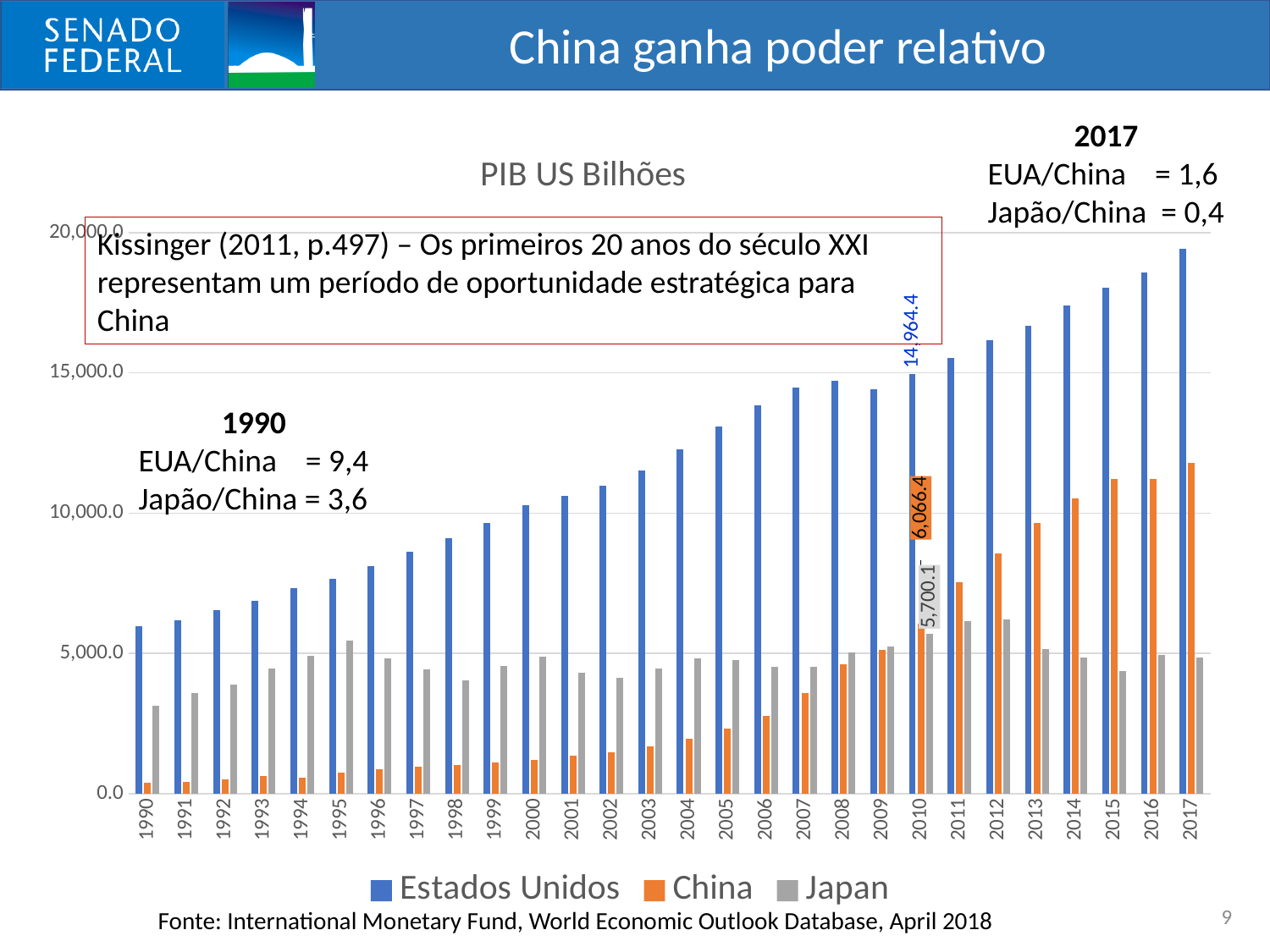
How many years are shown along the x axis of the chart? 28 Is the value for Estados Unidos in 2017 greater or less than 15,000.0? greater What is the value for Estados Unidos in 2010? 14,964.4 What is the value for Japan in 2010? 5,700.1 What is the title of the chart? PIB US Bilhões What is the value for China in 2010? 6,066.4 In 2010, which is larger, the value for China or the value for Japan? China Is the value for China in 1990 greater or less than 5,000.0? less Do the values for China rise or fall from 1990 to 2017? rise What kind of chart is shown on the slide? bar chart What is the difference between the Estados Unidos and China values in 2010? 8,898.0 How many series does the chart legend list? 3